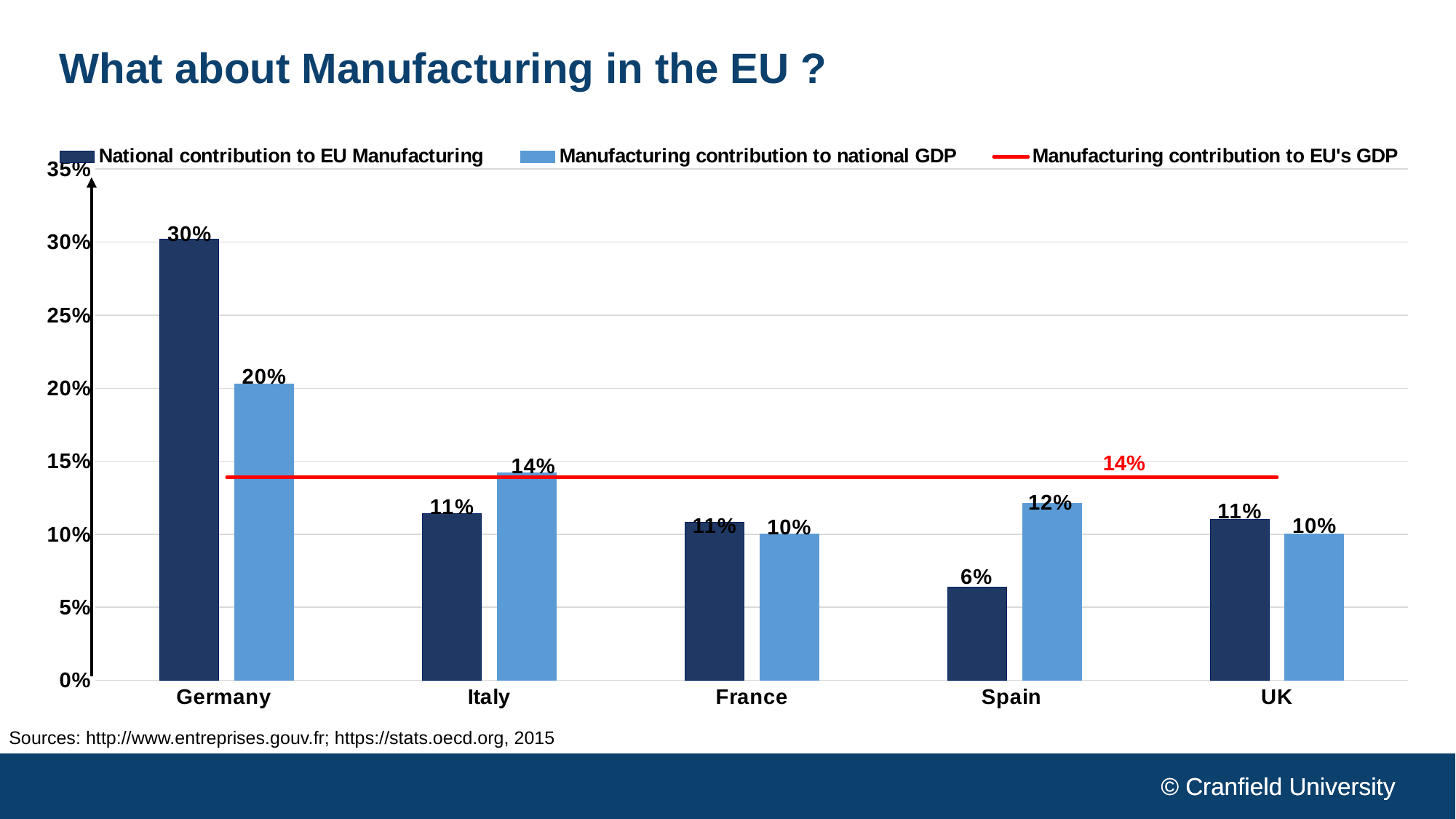
Which country has the lowest national contribution to EU Manufacturing? Spain Which country has the highest national contribution to EU Manufacturing? Germany How many countries are shown on the x axis? 5 What value does the red line for manufacturing contribution to EU's GDP show? 14% What is the manufacturing contribution to national GDP for Spain? 12% Is Germany's manufacturing contribution to national GDP greater or less than 15%? greater Which is larger for Italy: national contribution to EU Manufacturing or manufacturing contribution to national GDP? Manufacturing contribution to national GDP How many series does the legend list? 3 What is Germany's national contribution to EU Manufacturing? 30% What kind of chart is shown on the slide? Combination bar and line chart What colour is the line showing manufacturing contribution to EU's GDP? Red What is the difference between Germany's national contribution to EU Manufacturing and its manufacturing contribution to national GDP? 10%